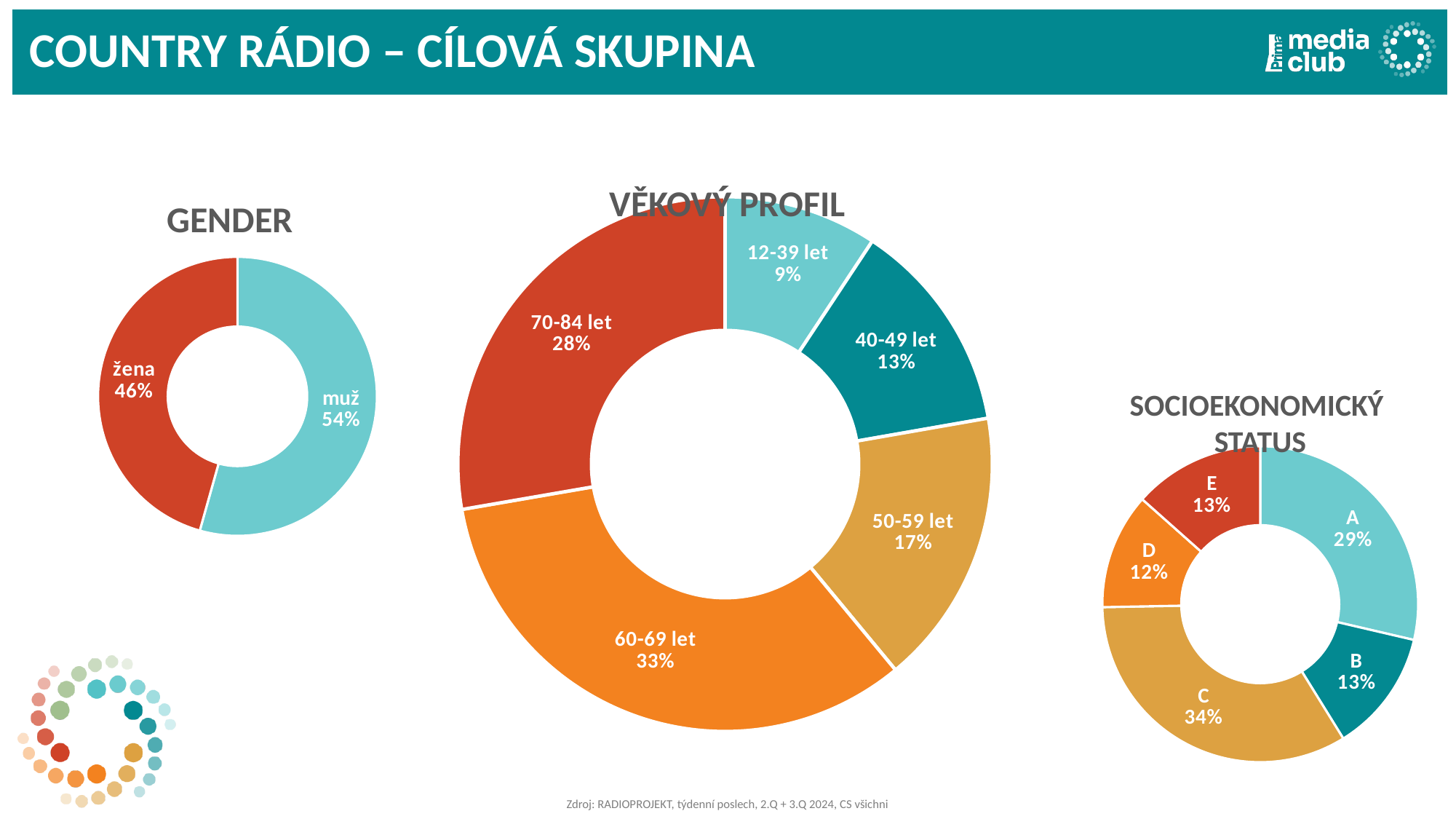
In the VĚKOVÝ PROFIL chart, how many age groups are shown? 5 In the VĚKOVÝ PROFIL chart, which age group has the smallest share? 12-39 let In the VĚKOVÝ PROFIL chart, what is the difference between the shares for 70-84 let and 50-59 let? 11% In the GENDER chart, what is the share for žena? 46% In the SOCIOEKONOMICKÝ STATUS chart, what is the difference between A and B? 16% In the VĚKOVÝ PROFIL chart, which age group has the largest share? 60-69 let In the SOCIOEKONOMICKÝ STATUS chart, which is larger, A or D? A How many charts are on the slide? 3 What kind of chart is the GENDER chart? Doughnut chart In the GENDER chart, what is the share for muž? 54% In the VĚKOVÝ PROFIL chart, what is the value for 60-69 let? 33% In the SOCIOEKONOMICKÝ STATUS chart, what is the value for category C? 34%